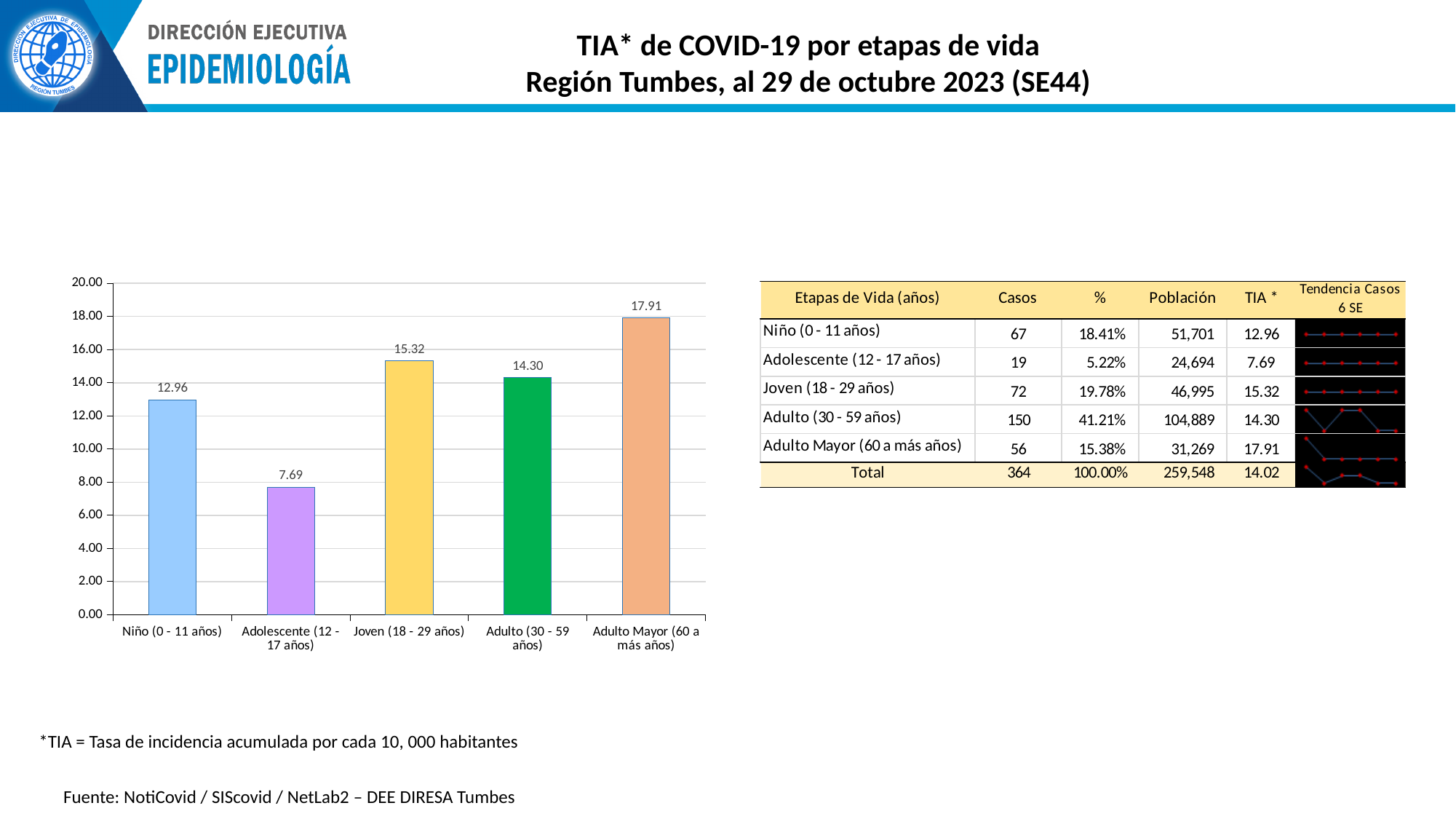
Is the TIA value for Niño (0 - 11 años) in the bar chart greater or less than 14.00? less Which life stage has the highest TIA in the bar chart? Adulto Mayor (60 a más años) What is the TIA value for Adulto Mayor (60 a más años) in the bar chart? 17.91 Which life stage has the lowest TIA in the bar chart? Adolescente (12 - 17 años) What is the TIA value for Adolescente (12 - 17 años) in the bar chart? 7.69 Which has a higher TIA in the bar chart, Joven (18 - 29 años) or Adulto (30 - 59 años)? Joven (18 - 29 años) What is the difference between the TIA for Adulto Mayor (60 a más años) and Niño (0 - 11 años) in the bar chart? 4.95 What colour is the bar for Adulto (30 - 59 años) in the bar chart? green What kind of chart is used to show TIA by life stage? bar chart How many life-stage categories are shown in the bar chart? 5 What is the TIA value for Joven (18 - 29 años) in the bar chart? 15.32 What is the maximum value shown on the y axis of the bar chart? 20.00